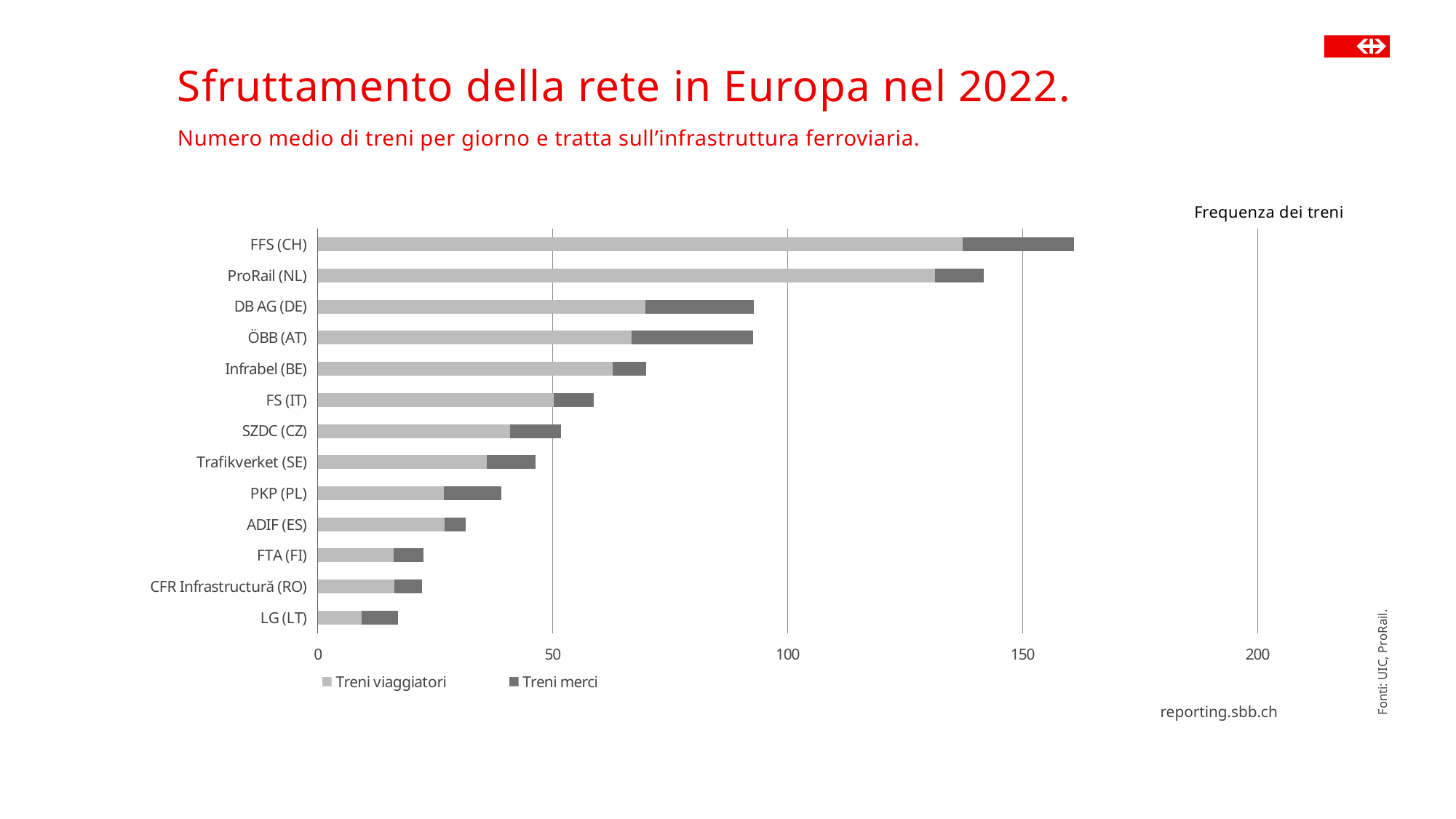
Which category has the lowest total train frequency? LG (LT) Is the total value for DB AG (DE) greater or less than 100? less What are the two series named in the legend? Treni viaggiatori and Treni merci Which has a larger total train frequency, Infrabel (BE) or FS (IT)? Infrabel (BE) Is the total value for Trafikverket (SE) greater or less than 50? less Is the total value for FFS (CH) greater or less than 150? greater Do the total values rise or fall going down the list of categories from FFS (CH) to LG (LT)? fall How many series does the legend list? 2 Which category has the highest total train frequency? FFS (CH) How many infrastructure managers (categories) are plotted in the chart? 13 What kind of chart is shown on the slide? stacked bar chart